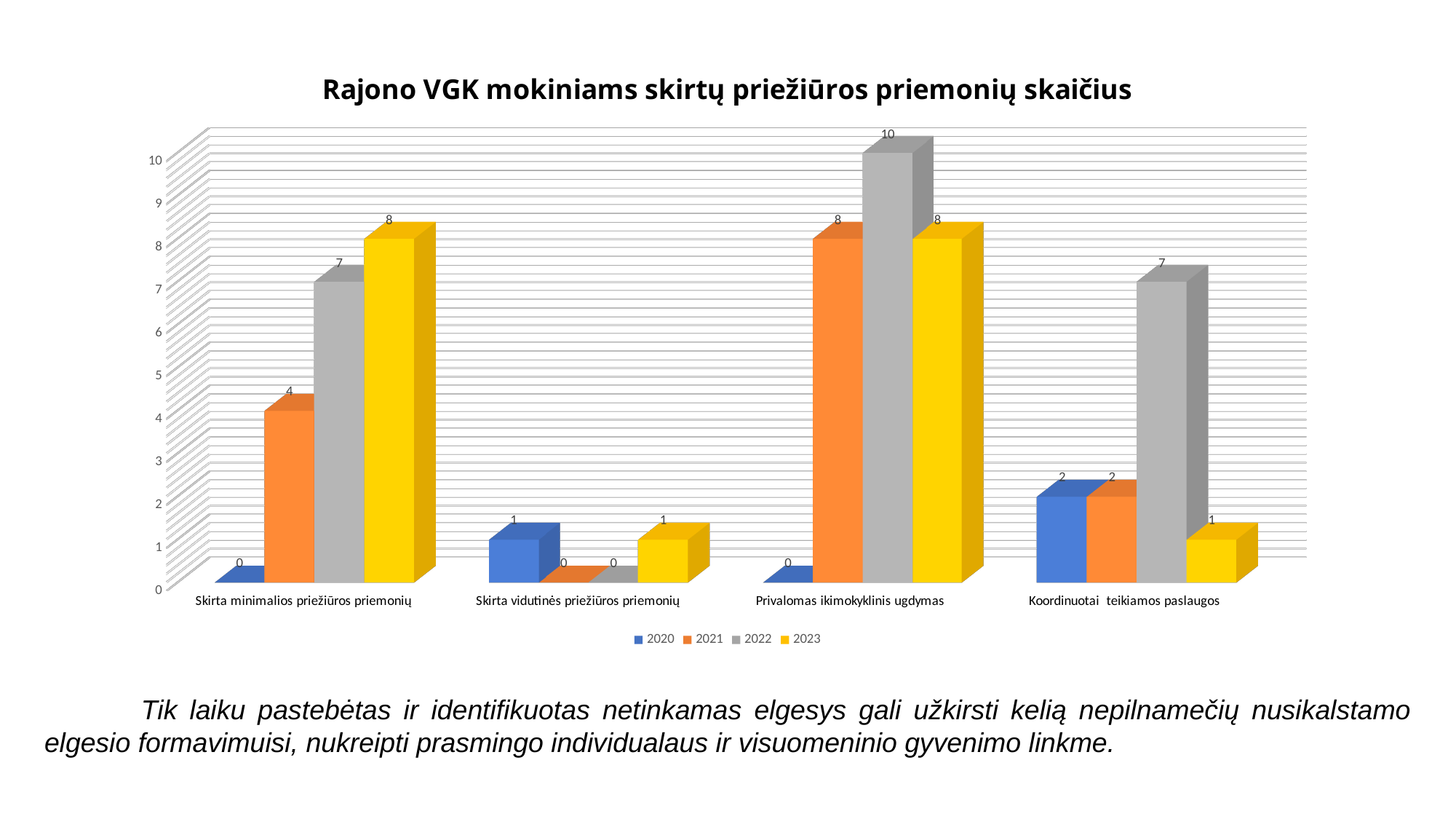
How many series does the legend list? 4 What kind of chart is shown on the slide? Bar chart What is the value for 2020 in the category "Skirta vidutinės priežiūros priemonių"? 1 What is the value for 2023 in the category "Koordinuotai teikiamos paslaugos"? 1 Which category has the lowest value for the 2023 series? Skirta vidutinės priežiūros priemonių and Koordinuotai teikiamos paslaugos (both 1) In the category "Koordinuotai teikiamos paslaugos", which is larger: the 2022 value or the 2023 value? 2022 What is the difference between the 2023 and 2021 values in the category "Skirta minimalios priežiūros priemonių"? 4 Which category has the highest value for the 2022 series? Privalomas ikimokyklinis ugdymas What is the title of the chart? Rajono VGK mokiniams skirtų priežiūros priemonių skaičius What is the value for 2021 in the category "Skirta minimalios priežiūros priemonių"? 4 How many categories are shown on the x axis? 4 What is the value for 2022 in the category "Privalomas ikimokyklinis ugdymas"? 10